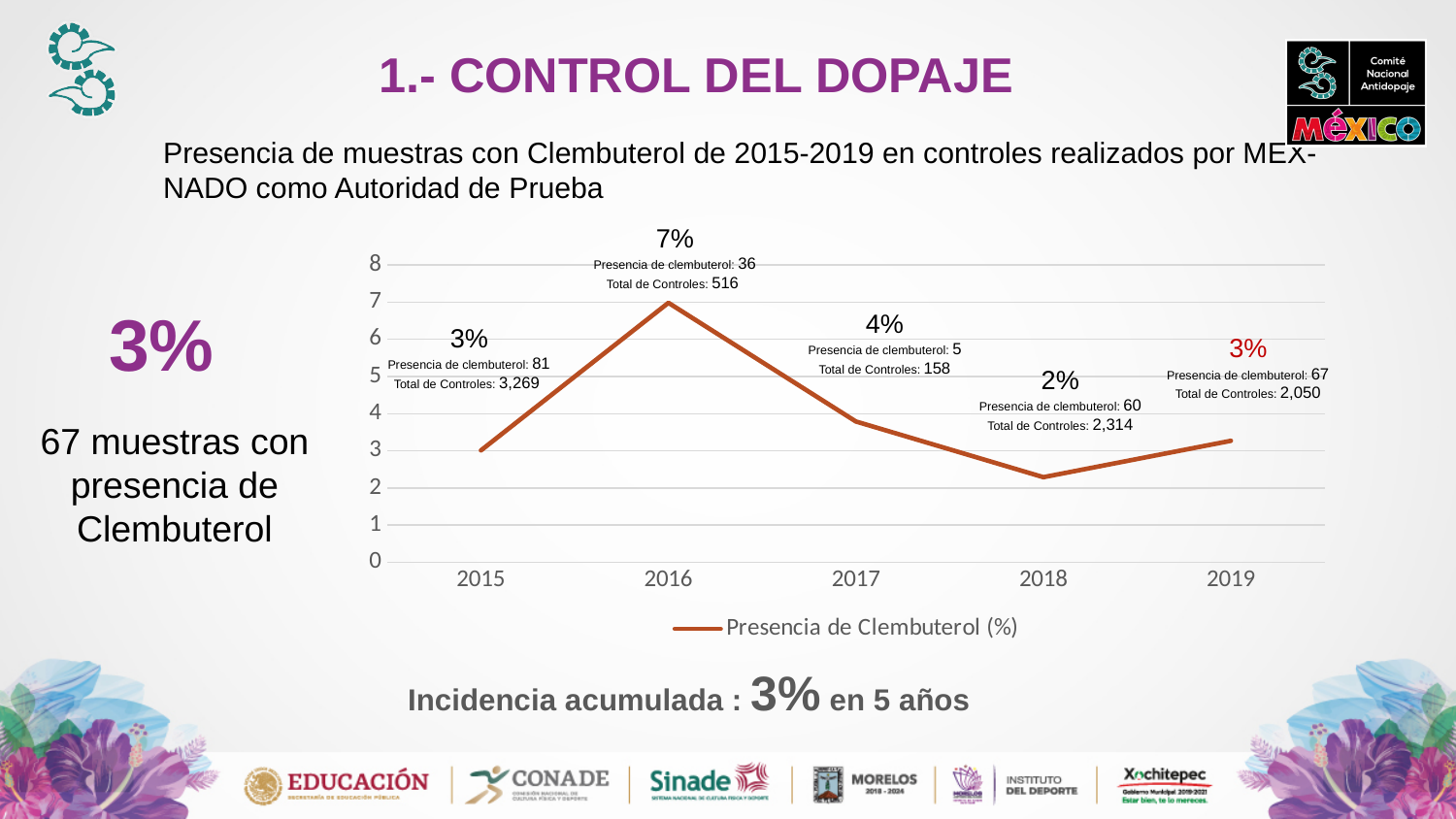
Is the Presencia de Clembuterol (%) value for 2016 greater or less than 6? greater According to the annotation, what is the Total de Controles for 2015? 3,269 What type of chart is shown on the slide? line chart How many years are plotted on the x axis? 5 What is the name of the series shown in the legend? Presencia de Clembuterol (%) Which year has the lowest Presencia de Clembuterol (%)? 2018 Which year has a larger Presencia de Clembuterol (%), 2016 or 2018? 2016 What is the Presencia de Clembuterol (%) value labeled for 2016? 7% What is the Presencia de Clembuterol (%) value labeled for 2018? 2% What is the Presencia de Clembuterol (%) value labeled for 2017? 4% How many series does the legend list? 1 Which year has the highest Presencia de Clembuterol (%)? 2016